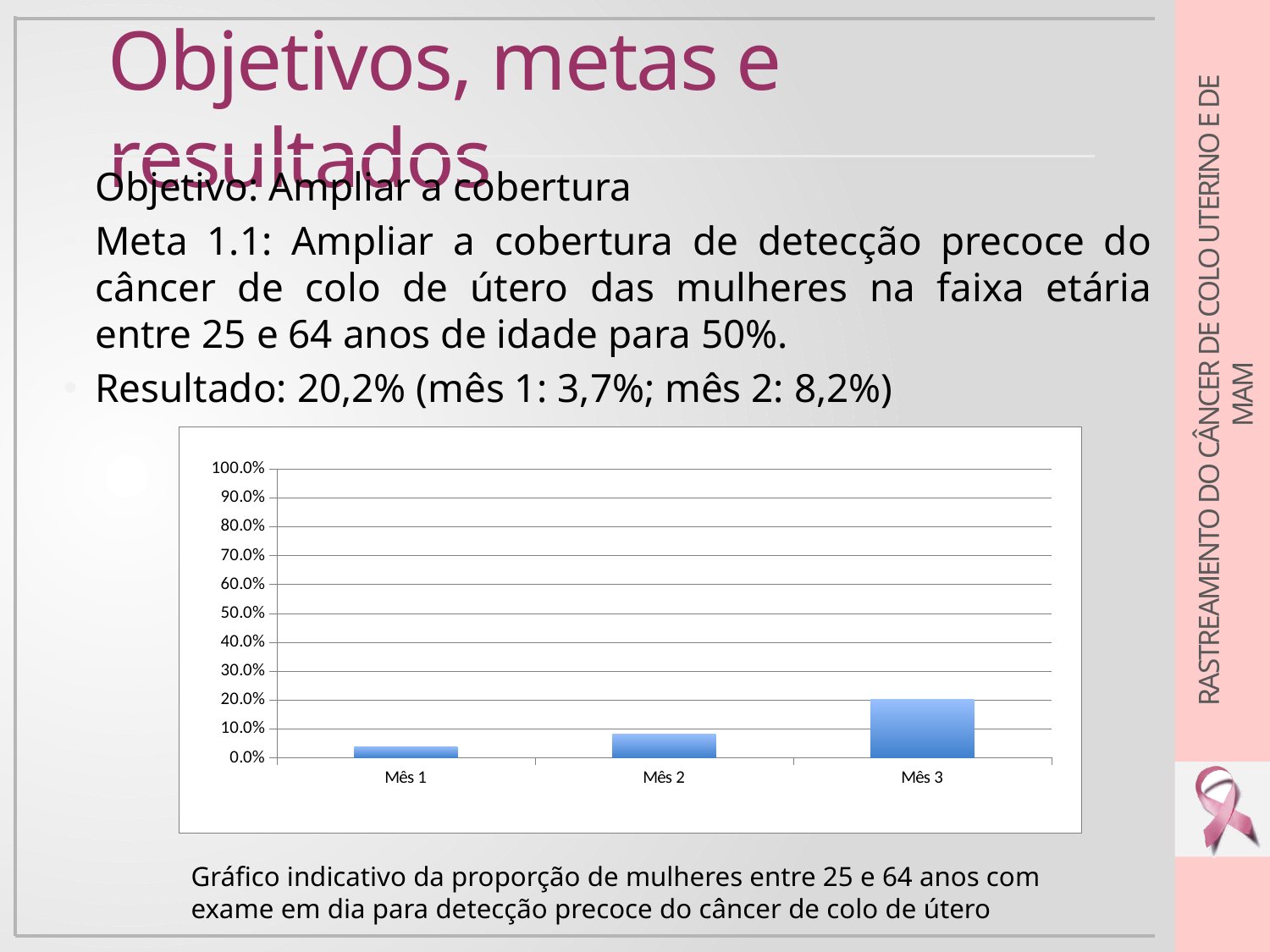
Do the values rise or fall from Mês 1 to Mês 3? rise What is the highest tick value shown on the y axis of the chart? 100.0% Is the value for Mês 3 greater or less than 30.0%? less What kind of chart is shown on the slide? bar chart Is the value for Mês 1 greater or less than 10.0%? less Which month has the lowest bar in the chart? Mês 1 What colour are the bars in the chart? blue Which is larger, the value for Mês 2 or the value for Mês 1? Mês 2 How many categories are shown on the x axis of the chart? 3 Is the value for Mês 3 greater or less than 10.0%? greater Which month has the highest bar in the chart? Mês 3